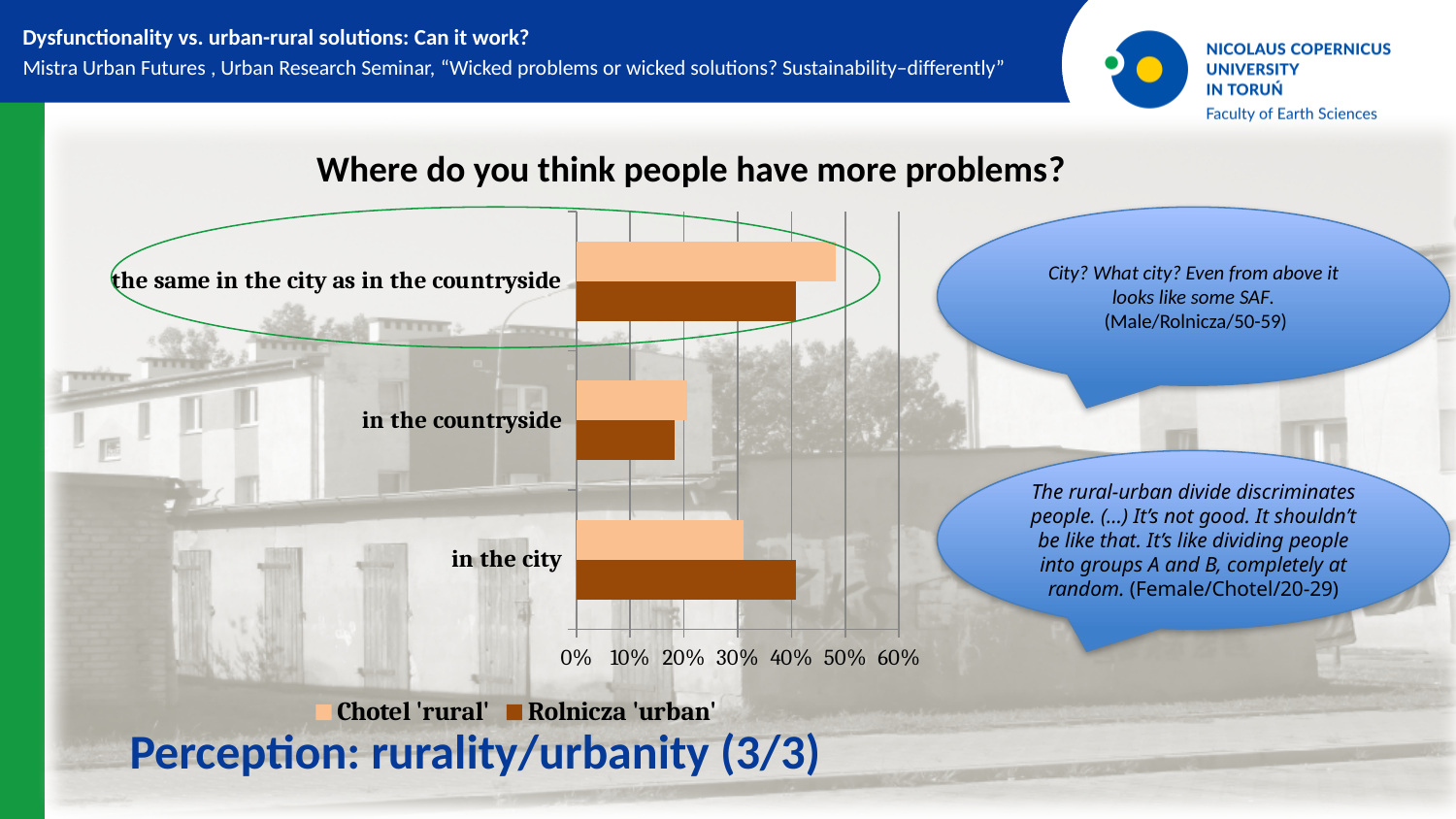
For the Chotel 'rural' series, which category has the highest value? the same in the city as in the countryside For the Rolnicza 'urban' series, which category has the lowest value? in the countryside What kind of chart is shown on the slide? bar chart For the Chotel 'rural' series, which category has the lowest value? in the countryside For the category 'in the city', which series has the larger value, Chotel 'rural' or Rolnicza 'urban'? Rolnicza 'urban' How many response categories does the chart show? 3 How many series does the chart legend list? 2 What is the title of the chart? Where do you think people have more problems? Is the Chotel 'rural' value for 'the same in the city as in the countryside' greater or less than 40%? greater Which two series are listed in the chart legend? Chotel 'rural' and Rolnicza 'urban' Is the Chotel 'rural' value for 'in the city' greater or less than 40%? less For the category 'the same in the city as in the countryside', which series has the larger value, Chotel 'rural' or Rolnicza 'urban'? Chotel 'rural'